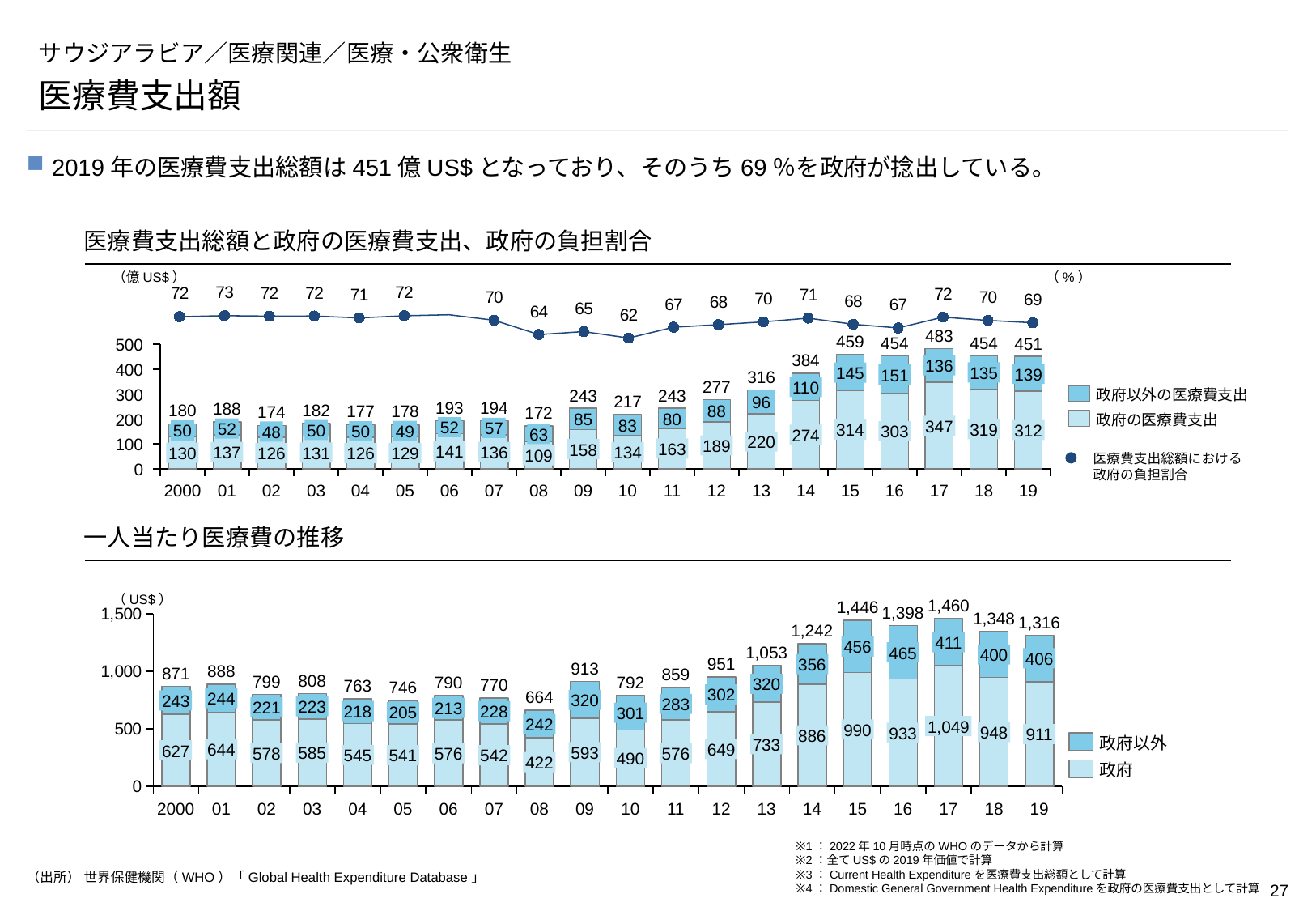
「医療費支出総額と政府の医療費支出、政府の負担割合」のグラフで、政府の負担割合が最も低い年とその値は？ 2010年、62% 「一人当たり医療費の推移」のグラフで、2015年と2016年では、どちらの合計が大きいですか？ 2015年 「医療費支出総額と政府の医療費支出、政府の負担割合」のグラフの凡例には、いくつの系列が示されていますか？ 3 「医療費支出総額と政府の医療費支出、政府の負担割合」のグラフで、医療費支出総額が最も大きい年はどの年ですか？ 2017年（483） 「一人当たり医療費の推移」のグラフには、何年分のデータが示されていますか？ 20 「一人当たり医療費の推移」のグラフで、一人当たり医療費の合計が最も大きい年はどの年ですか？ 2017年（1,460） 「医療費支出総額と政府の医療費支出、政府の負担割合」のグラフで、2014年の政府の医療費支出はいくらですか？ 274 「医療費支出総額と政府の医療費支出、政府の負担割合」のグラフで、医療費支出総額が最も小さい年はどの年ですか？ 2008年（172） 「医療費支出総額と政府の医療費支出、政府の負担割合」のグラフで、2017年と2019年の医療費支出総額の差はいくらですか？ 32 「一人当たり医療費の推移」のグラフで、一人当たり医療費の合計が最も小さい年はどの年ですか？ 2008年（664） 「医療費支出総額と政府の医療費支出、政府の負担割合」のグラフで、2019年の医療費支出総額はいくらですか？ 451 「一人当たり医療費の推移」のグラフで、2015年の政府以外の一人当たり医療費はいくらですか？ 456